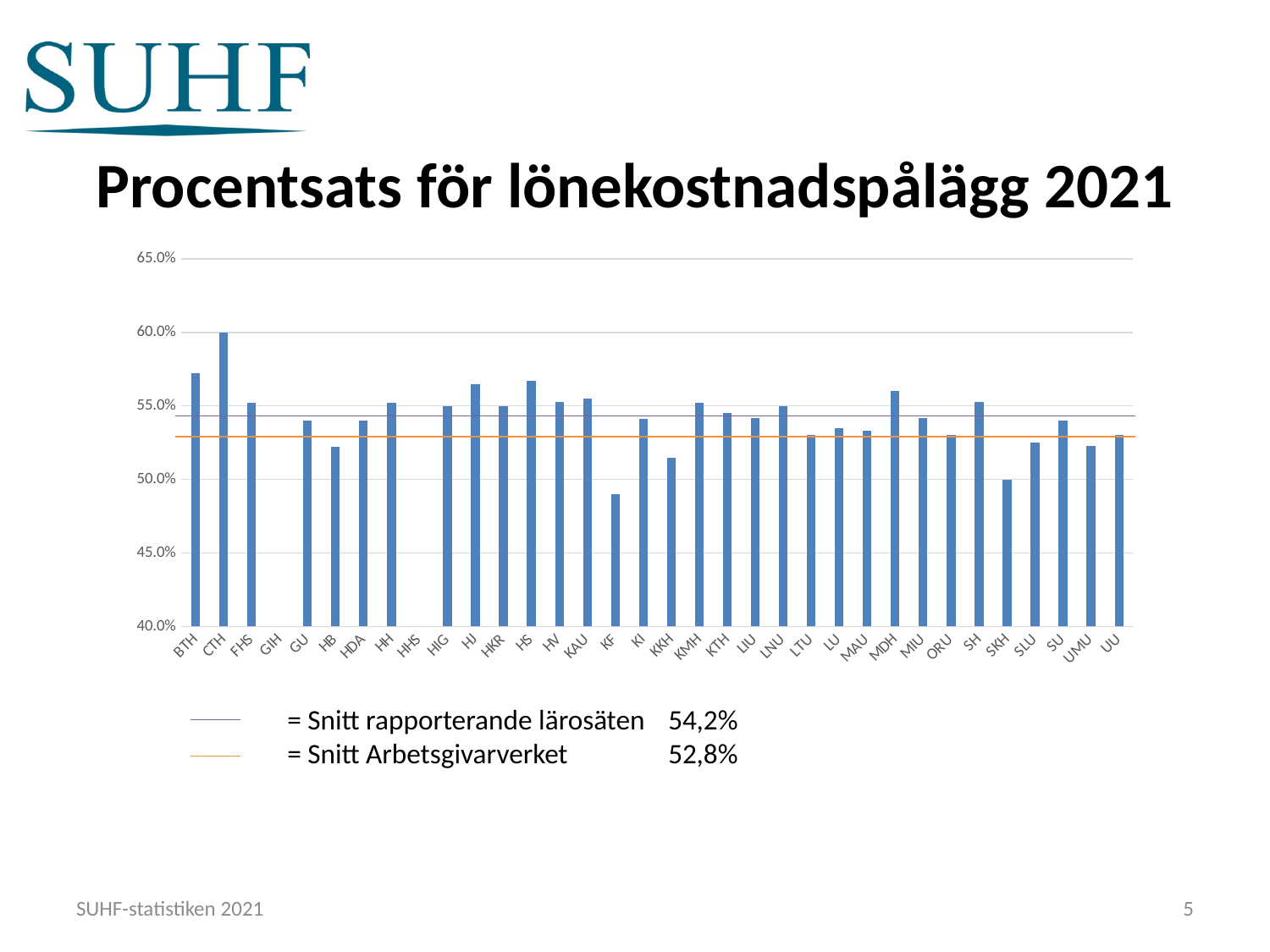
Which is larger, the value for CTH or the value for BTH? CTH Is the value for KKH greater or less than 55.0%? less Is the value for HS greater or less than 55.0%? greater What value is given on the slide for 'Snitt rapporterande lärosäten'? 54,2% Which is larger, the value for KF or the value for KKH? KKH What is the title of the chart? Procentsats för lönekostnadspålägg 2021 What kind of chart is shown on the slide? bar chart Which category has the lowest bar in the chart? KF Which category has the highest bar in the chart? CTH Is the value for HB greater or less than 55.0%? less